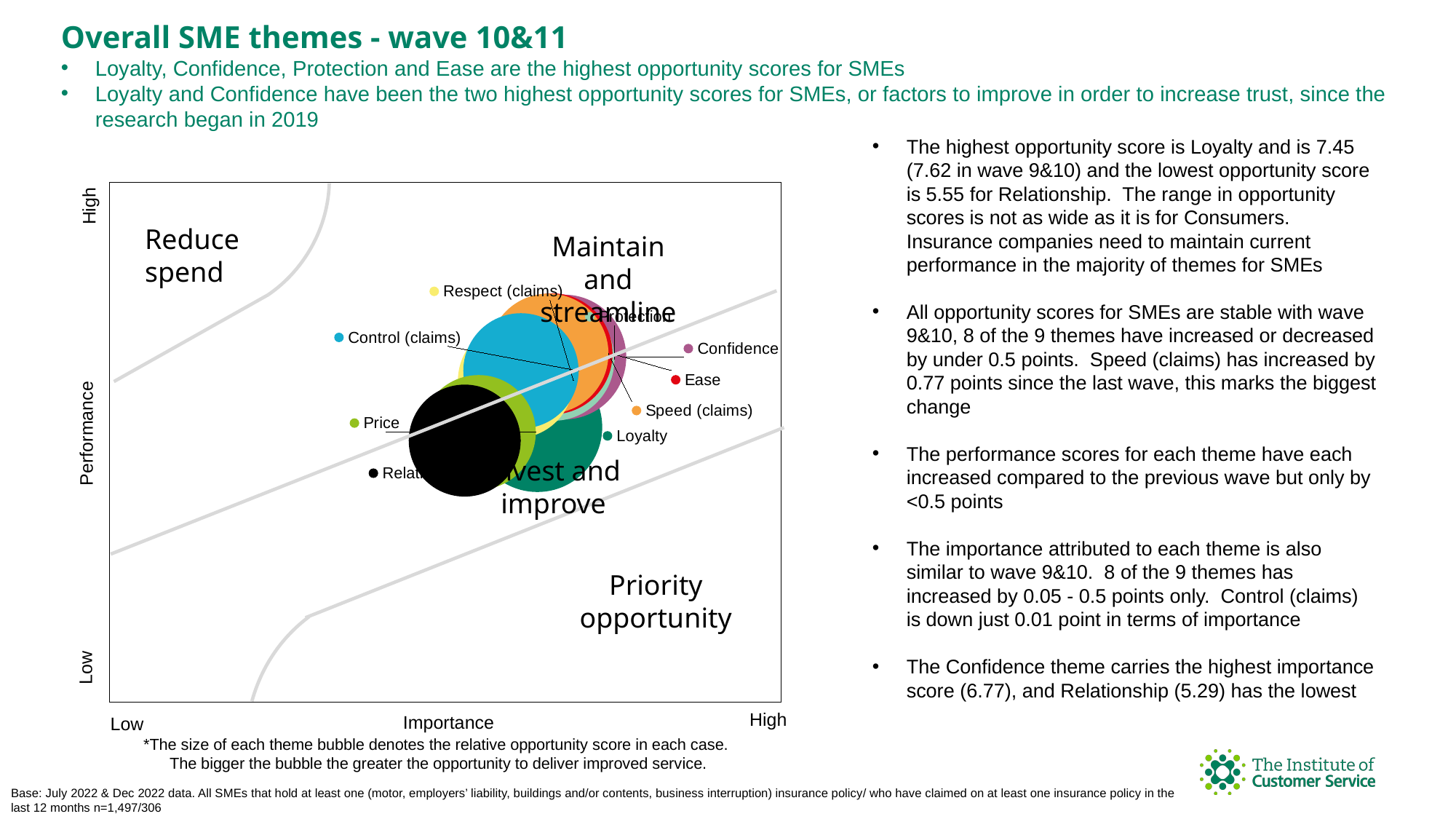
Which theme has the higher importance on the chart, Confidence or Relationship? Confidence What does the size of each bubble on the chart denote? The relative opportunity score Which theme is plotted furthest to the left (lowest importance) on the chart? Relationship Which theme has the higher importance on the chart, Price or Ease? Ease How many themes are plotted as bubbles on the chart? 9 What kind of chart is shown on the slide? Bubble chart What does the x axis of the chart represent? Importance Which theme is plotted furthest to the right (highest importance) on the chart? Confidence